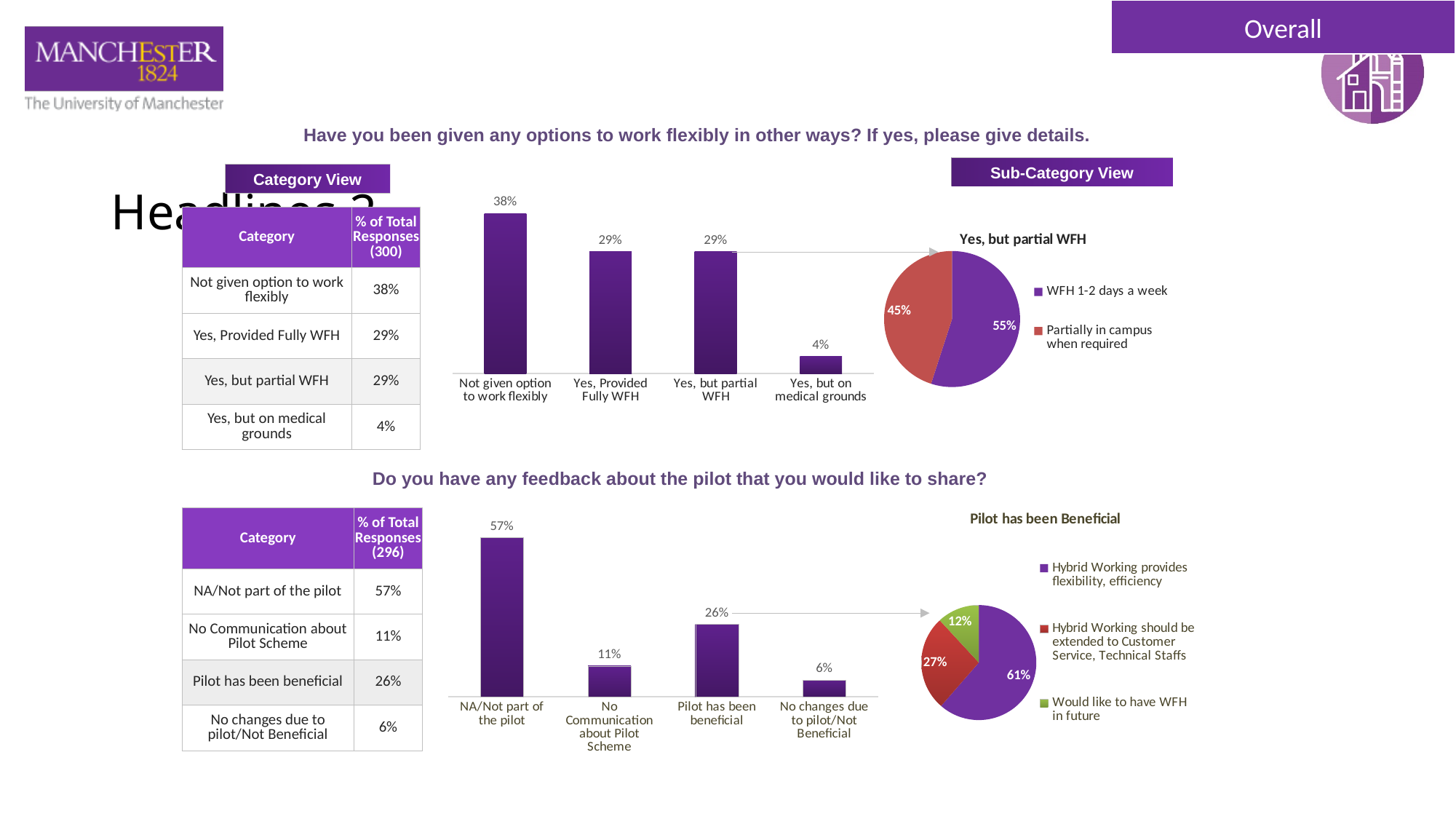
In the top bar chart about options to work flexibly, which category has the lowest value? Yes, but on medical grounds In the top bar chart about options to work flexibly, what is the value for 'Not given option to work flexibly'? 38% How many entries does the legend of the pie chart titled 'Pilot has been Beneficial' list? 3 In the top bar chart about options to work flexibly, what is the difference between 'Not given option to work flexibly' and 'Yes, but on medical grounds'? 34% What type of chart is the chart titled 'Yes, but partial WFH'? Pie chart How many categories are shown in the top bar chart about options to work flexibly? 4 In the pie chart titled 'Pilot has been Beneficial', what share is 'Would like to have WFH in future'? 12% In the bottom bar chart about pilot feedback, what is the value for 'Pilot has been beneficial'? 26% In the bottom bar chart about pilot feedback, what is the difference between 'NA/Not part of the pilot' and 'No Communication about Pilot Scheme'? 46% In the pie chart titled 'Yes, but partial WFH', what share is 'WFH 1-2 days a week'? 55% In the bottom bar chart about pilot feedback, which category has the highest value? NA/Not part of the pilot In the pie chart titled 'Yes, but partial WFH', which slice is larger: 'WFH 1-2 days a week' or 'Partially in campus when required'? WFH 1-2 days a week